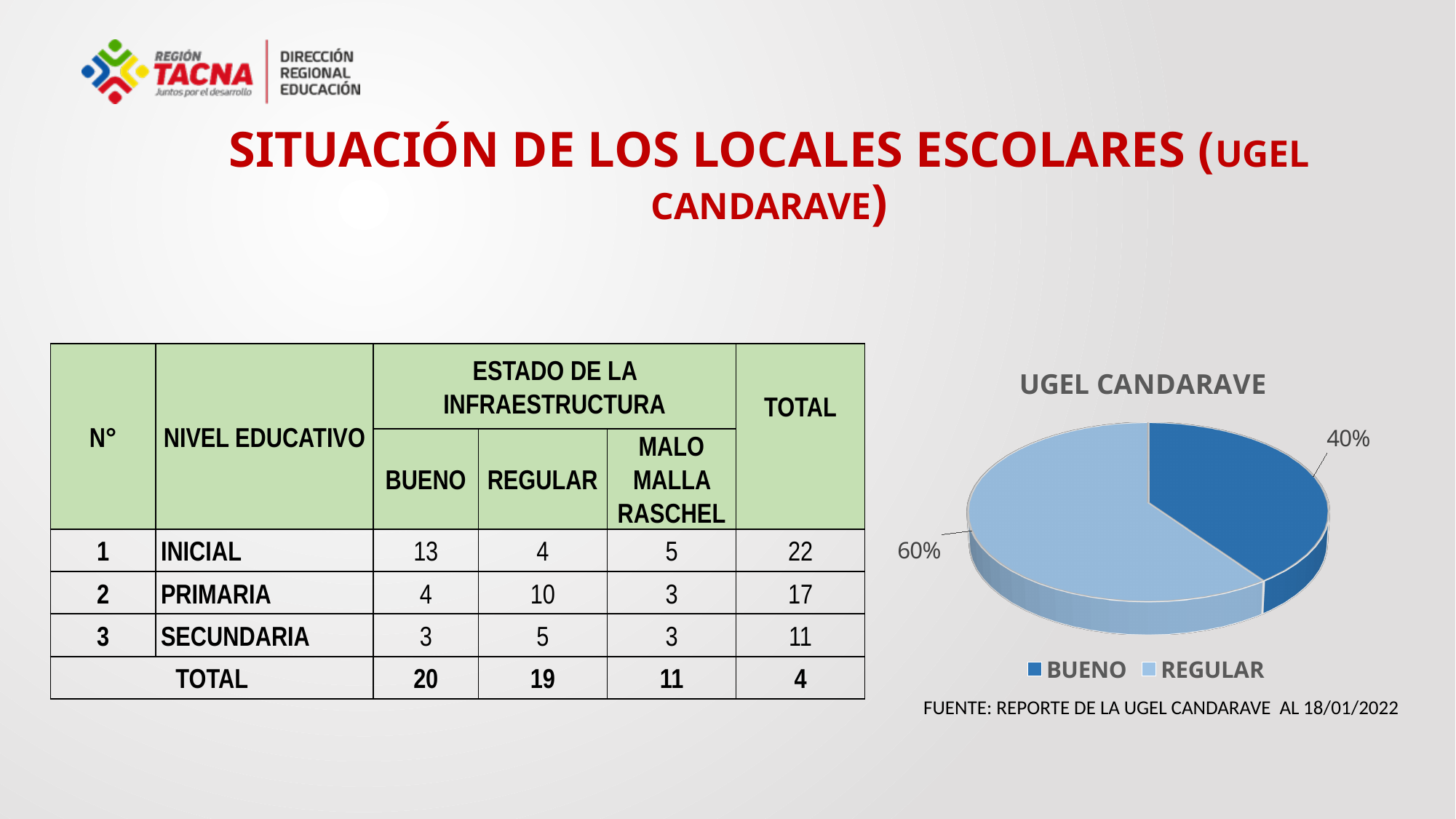
What share of the pie does the REGULAR slice represent? 60% Which is larger in the pie chart, BUENO or REGULAR? REGULAR How many slices does the pie chart have? 2 What is the title of the pie chart? UGEL CANDARAVE What percentage does the BUENO slice show in the pie chart? 40% How many entries does the legend of the pie chart list? 2 Which legend entry is shown in the darker blue colour in the pie chart? BUENO Which slice of the pie chart is the smallest? BUENO What type of chart is shown on the slide? Pie chart What is the difference in percentage points between the REGULAR and BUENO slices? 20% What percentage does the REGULAR slice show in the pie chart? 60% Which slice of the pie chart is the largest? REGULAR